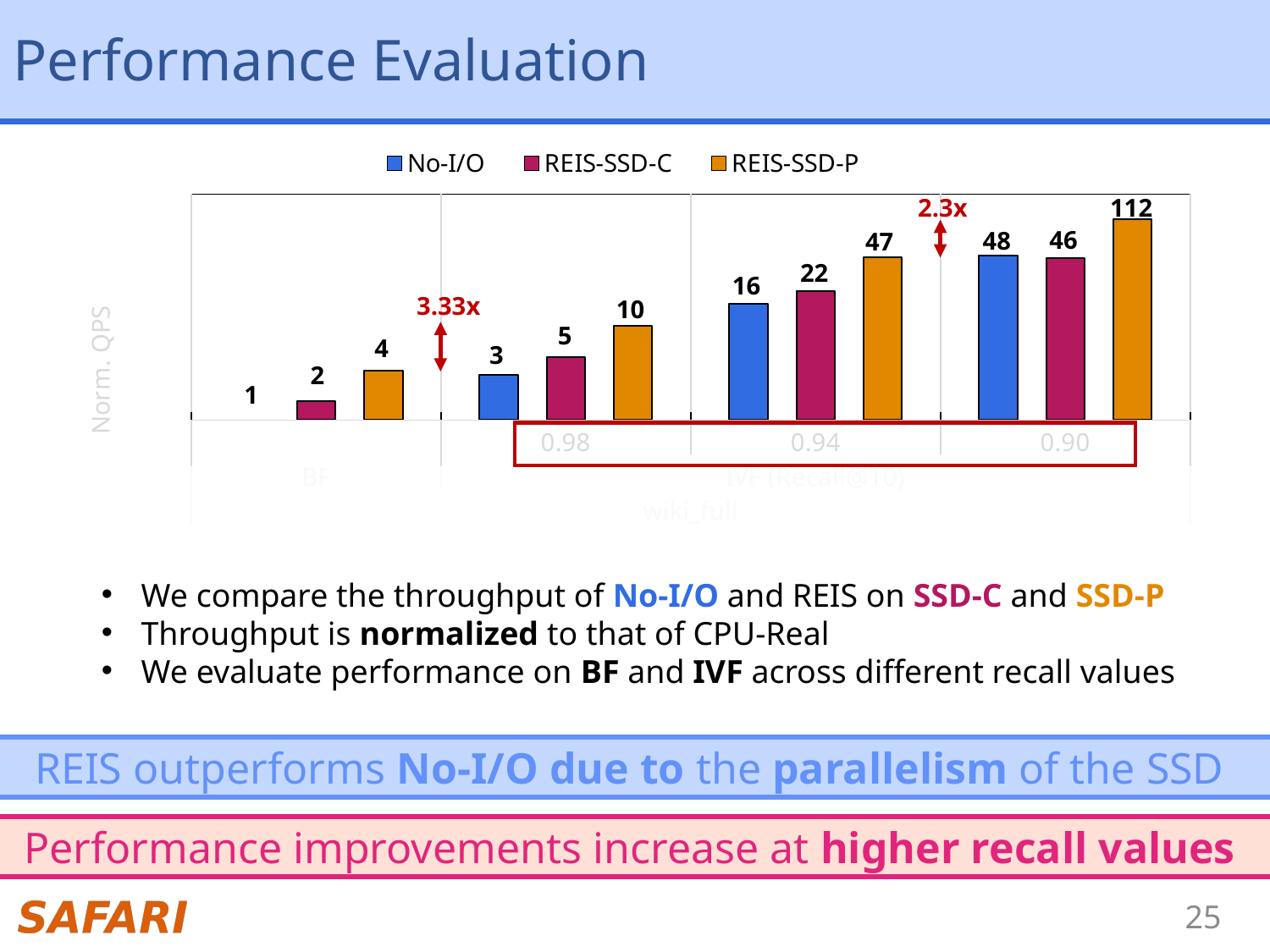
How many series does the chart legend list? 3 What speedup annotation is shown in red above the IVF recall 0.98 group? 3.33x What type of chart is shown on the slide? bar chart What is the difference between REIS-SSD-P and No-I/O at IVF recall 0.94? 31 What is the value of No-I/O at IVF recall 0.94? 16 What is the value of REIS-SSD-P at IVF recall 0.90? 112 What is the value of REIS-SSD-C at IVF recall 0.98? 5 What is the value of REIS-SSD-P for the BF category? 4 Which series has the lowest value in the BF category? No-I/O Which series has the highest value at IVF recall 0.90? REIS-SSD-P Do the No-I/O values rise or fall moving from BF to IVF recall 0.90 along the x axis? rise Which is larger at IVF recall 0.98: REIS-SSD-P or REIS-SSD-C? REIS-SSD-P